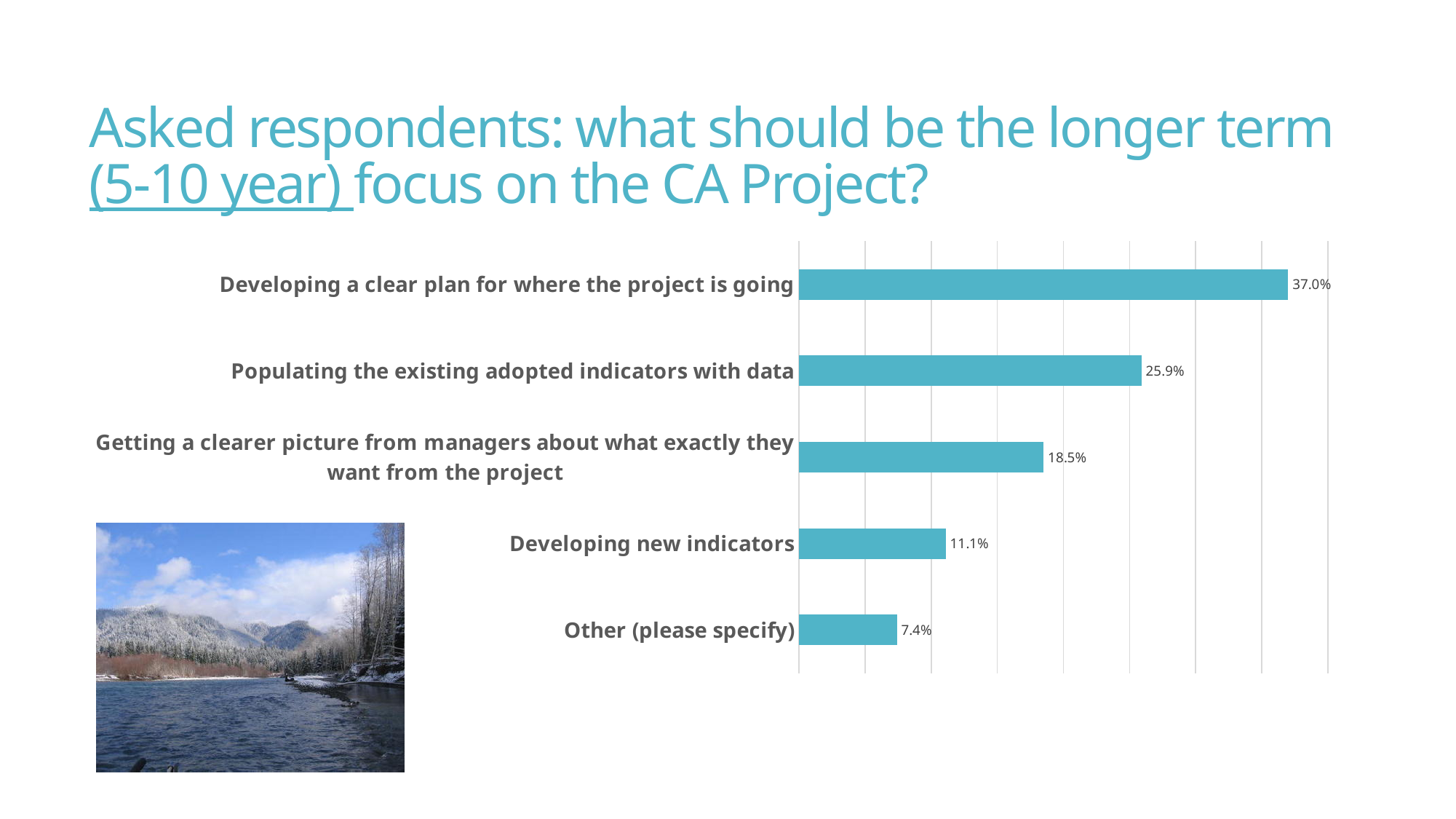
What is the value for "Getting a clearer picture from managers about what exactly they want from the project"? 18.5% What kind of chart is shown on the slide? Bar chart Which is larger: the value for "Developing new indicators" or the value for "Other (please specify)"? Developing new indicators How many categories are shown in the chart? 5 What is the value for "Populating the existing adopted indicators with data"? 25.9% What is the difference between "Getting a clearer picture from managers about what exactly they want from the project" and "Developing new indicators"? 7.4% Which category has the highest value? Developing a clear plan for where the project is going Which category has the lowest value? Other (please specify) What is the difference between "Developing a clear plan for where the project is going" and "Populating the existing adopted indicators with data"? 11.1% What is the value for "Developing new indicators"? 11.1% What is the value for "Other (please specify)"? 7.4% What percentage of respondents chose "Developing a clear plan for where the project is going"? 37.0%